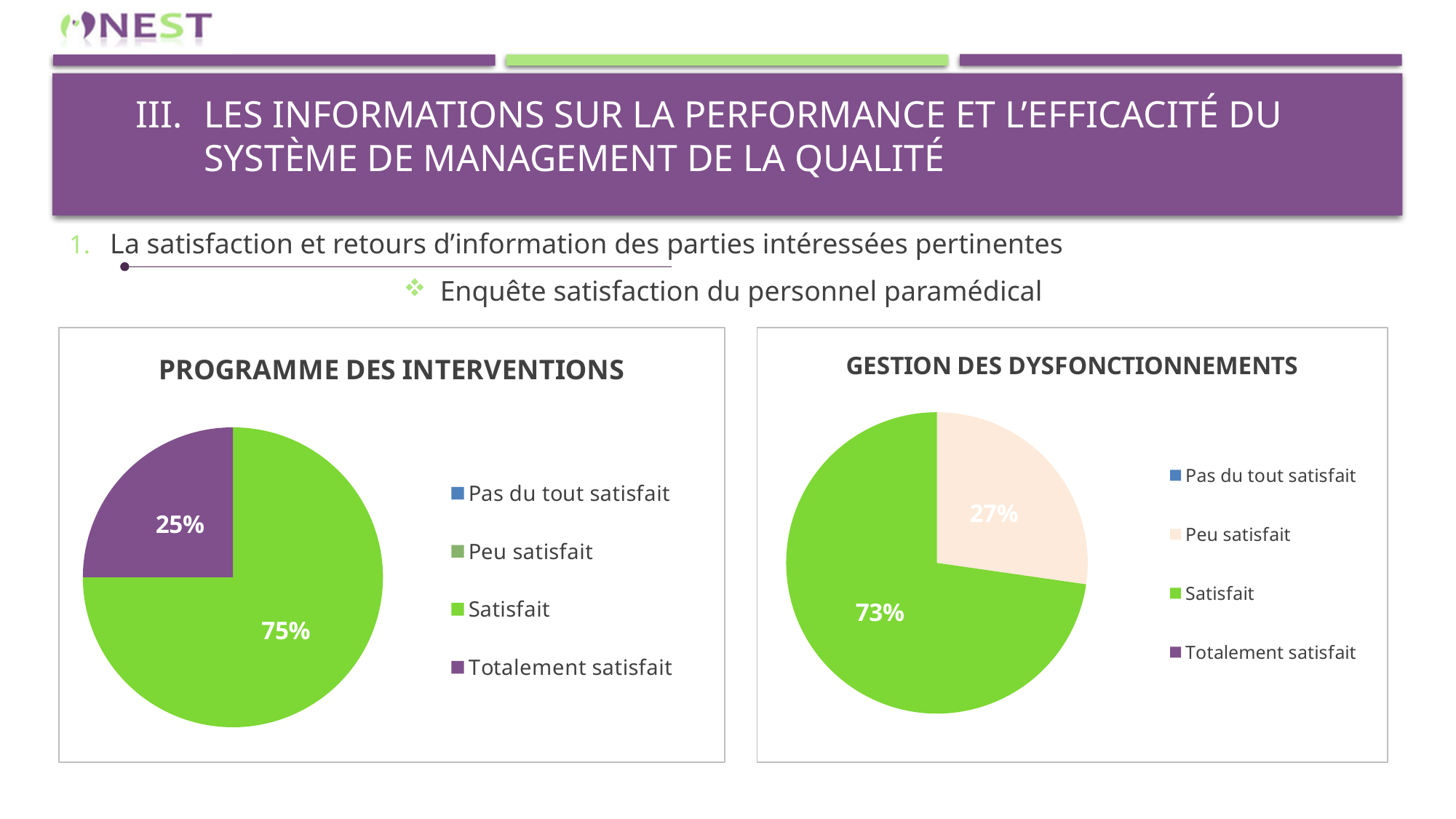
In the 'PROGRAMME DES INTERVENTIONS' chart, which category has the largest slice? Satisfait Which is larger: the 'Satisfait' share in the 'PROGRAMME DES INTERVENTIONS' chart or the 'Satisfait' share in the 'GESTION DES DYSFONCTIONNEMENTS' chart? PROGRAMME DES INTERVENTIONS In the 'PROGRAMME DES INTERVENTIONS' chart, what share of respondents are 'Satisfait'? 75% What type of chart is the 'GESTION DES DYSFONCTIONNEMENTS' chart? Pie chart How many entries does the legend of the 'PROGRAMME DES INTERVENTIONS' chart list? 4 In the 'GESTION DES DYSFONCTIONNEMENTS' chart, what colour is the 'Satisfait' slice? Green In the 'GESTION DES DYSFONCTIONNEMENTS' chart, what share of respondents are 'Peu satisfait'? 27% In the 'PROGRAMME DES INTERVENTIONS' chart, what is the difference between the 'Satisfait' and 'Totalement satisfait' shares? 50% In the 'GESTION DES DYSFONCTIONNEMENTS' chart, which category has the largest slice? Satisfait In the 'GESTION DES DYSFONCTIONNEMENTS' chart, what share of respondents are 'Satisfait'? 73% In the 'PROGRAMME DES INTERVENTIONS' chart, what share of respondents are 'Totalement satisfait'? 25% In the 'GESTION DES DYSFONCTIONNEMENTS' chart, what is the difference between the 'Satisfait' and 'Peu satisfait' shares? 46%